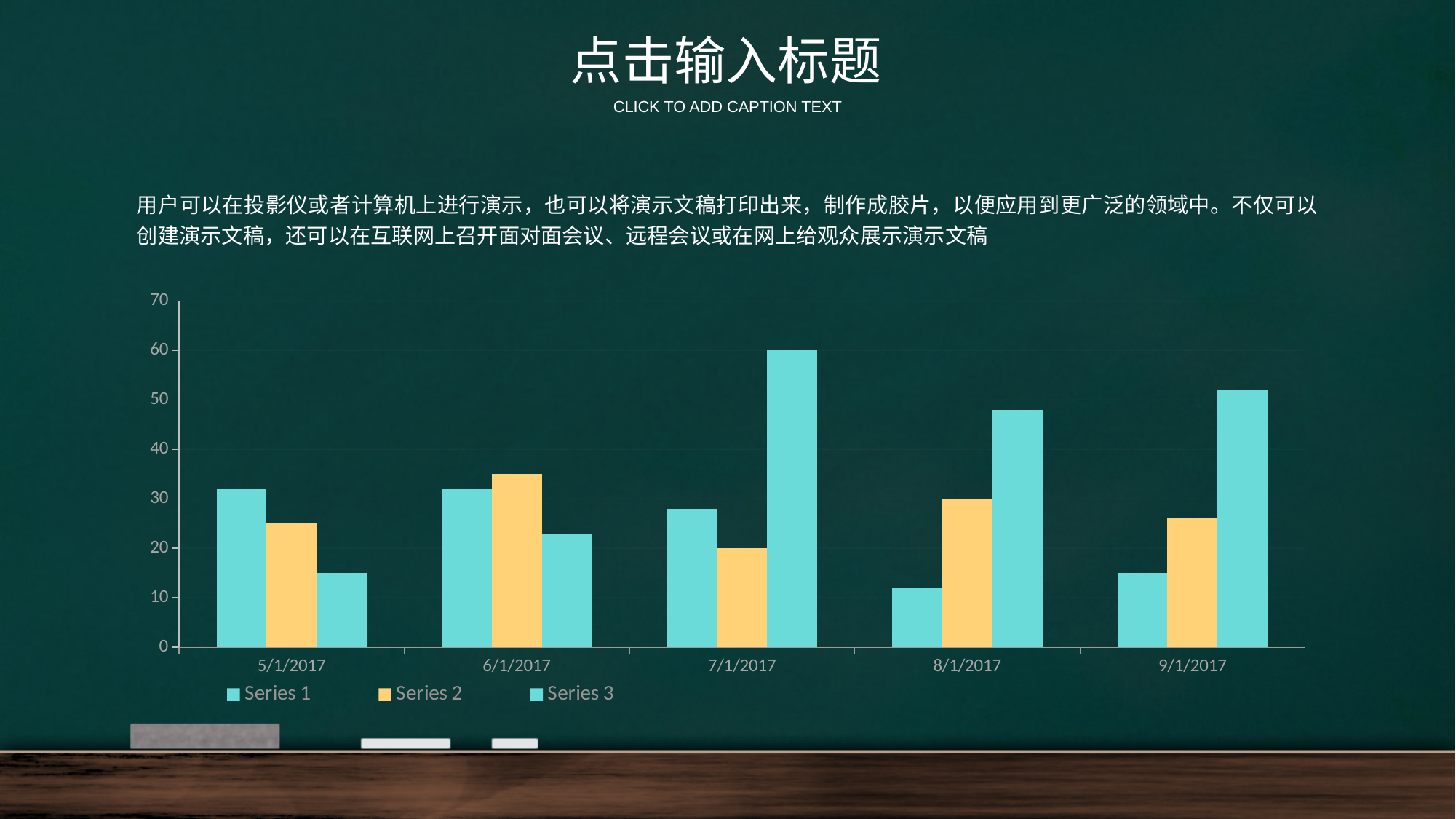
At 5/1/2017, which is larger: Series 1 or Series 3? Series 1 Does Series 3 rise or fall from 5/1/2017 to 7/1/2017? rise How many series does the legend list? 3 For which date is the Series 3 bar the highest? 7/1/2017 Is the value for Series 3 at 9/1/2017 greater or less than 50? greater What is the value of Series 2 for 8/1/2017? 30 How many date categories are shown on the x axis? 5 What kind of chart is shown on the slide? bar chart What is the value of Series 3 for 7/1/2017? 60 For which date is the Series 1 bar the lowest? 8/1/2017 For which date is the Series 2 bar the highest? 6/1/2017 Is the value for Series 1 at 8/1/2017 greater or less than 20? less